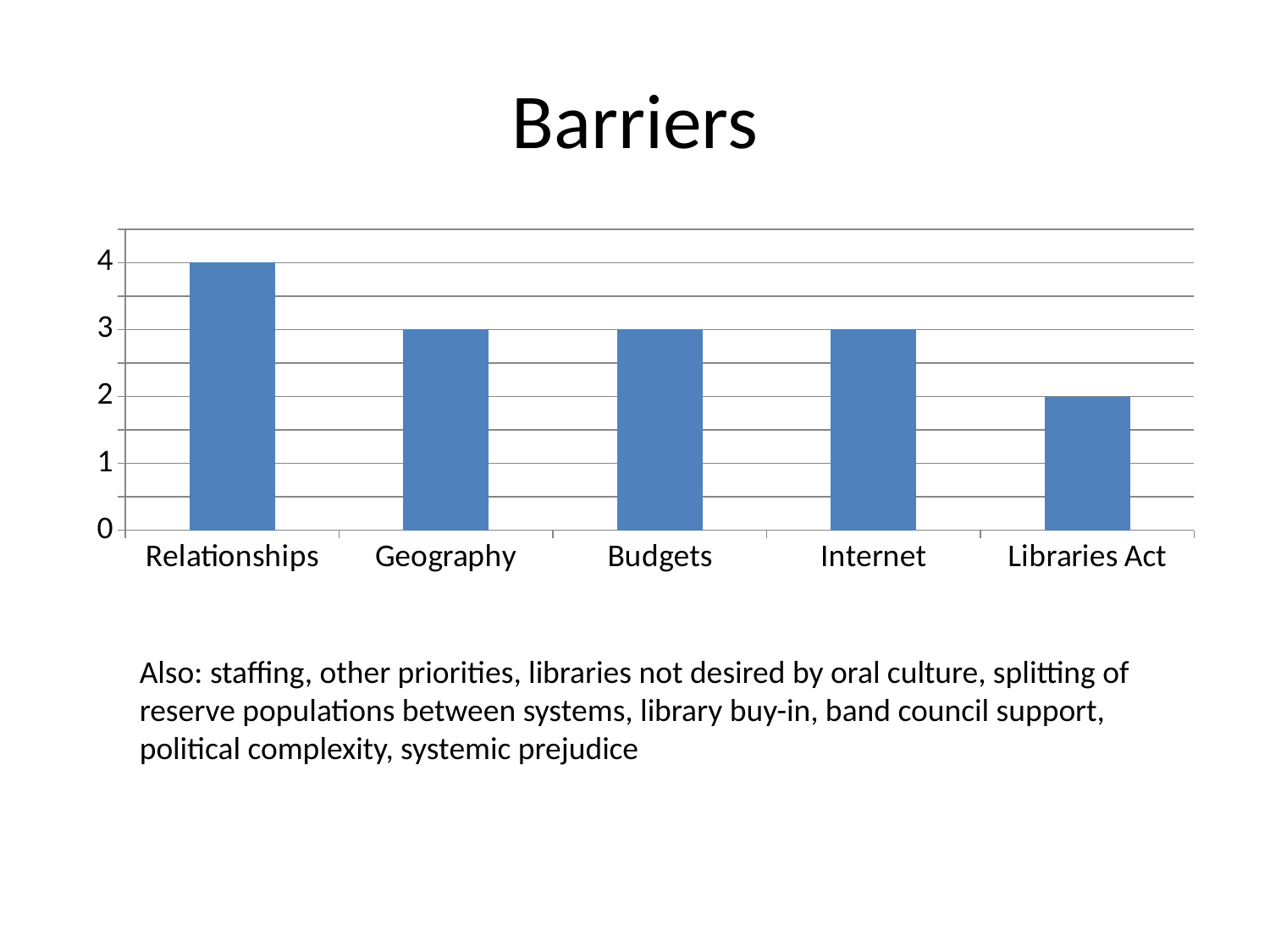
What is the value for Libraries Act? 2 Which is larger, the value for Budgets or the value for Libraries Act? Budgets What is the value for Geography? 3 Is the value for Internet greater or less than 2? greater What is the title of the slide? Barriers Which category has the highest value? Relationships How many categories are shown on the x axis? 5 How many categories have a value of 3? 3 What is the value for Relationships? 4 What is the difference between the values for Relationships and Libraries Act? 2 What kind of chart is shown on the slide? bar chart Which category has the lowest value? Libraries Act